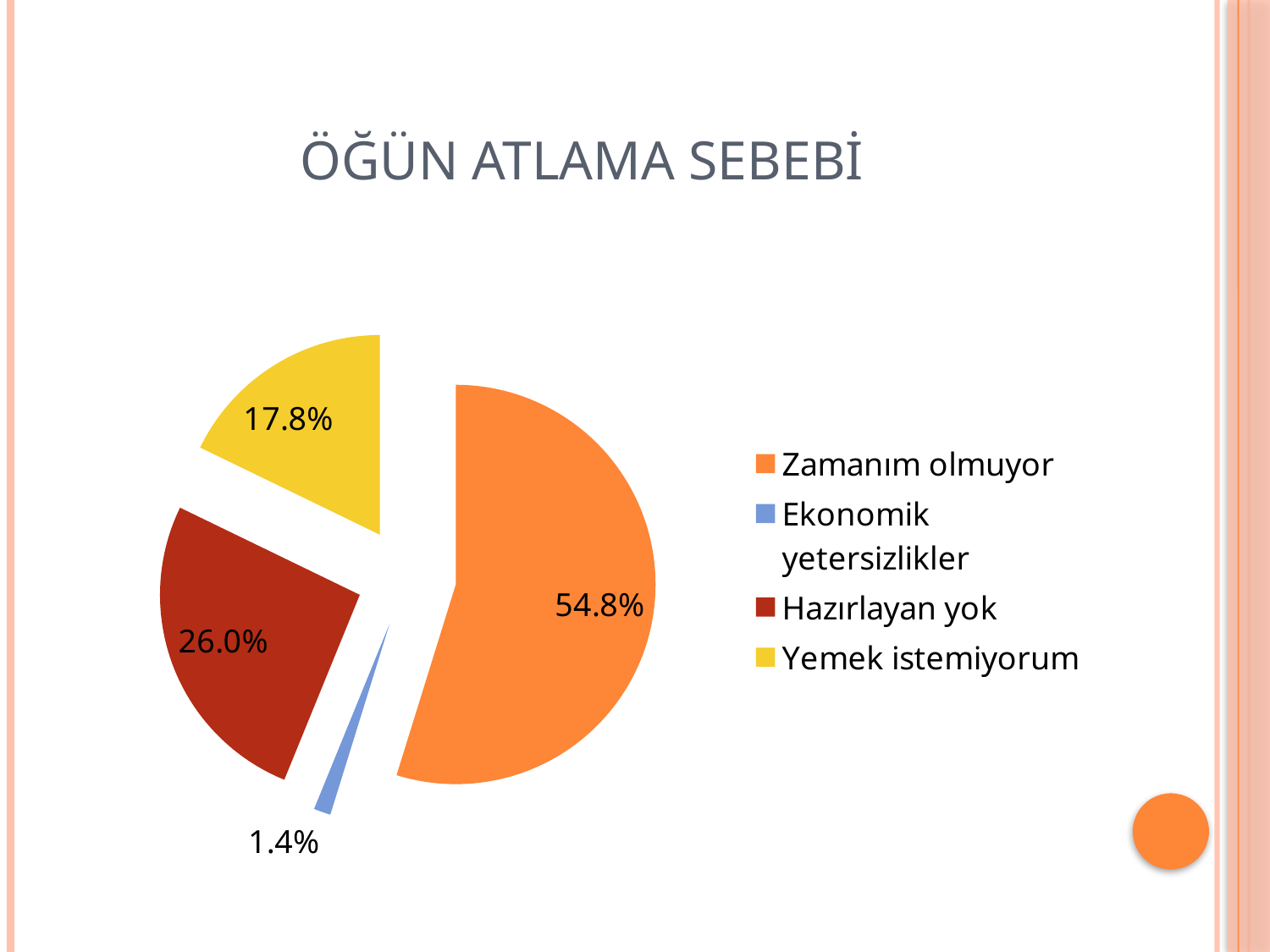
Which category has the smallest slice of the pie? Ekonomik yetersizlikler What share of the pie does "Ekonomik yetersizlikler" represent? 1.4% What share of the pie does "Hazırlayan yok" represent? 26.0% What kind of chart is shown on the slide? Pie chart What is the title of the slide containing the chart? ÖĞÜN ATLAMA SEBEBİ How many categories are shown in the pie chart? 4 Which is larger, the slice for "Hazırlayan yok" or the slice for "Yemek istemiyorum"? Hazırlayan yok What share of the pie does "Yemek istemiyorum" represent? 17.8% What is the difference in percentage points between "Zamanım olmuyor" and "Hazırlayan yok"? 28.8 Which category has the largest slice of the pie? Zamanım olmuyor What share of the pie does "Zamanım olmuyor" represent? 54.8% Which colour represents "Yemek istemiyorum" in the legend? Yellow